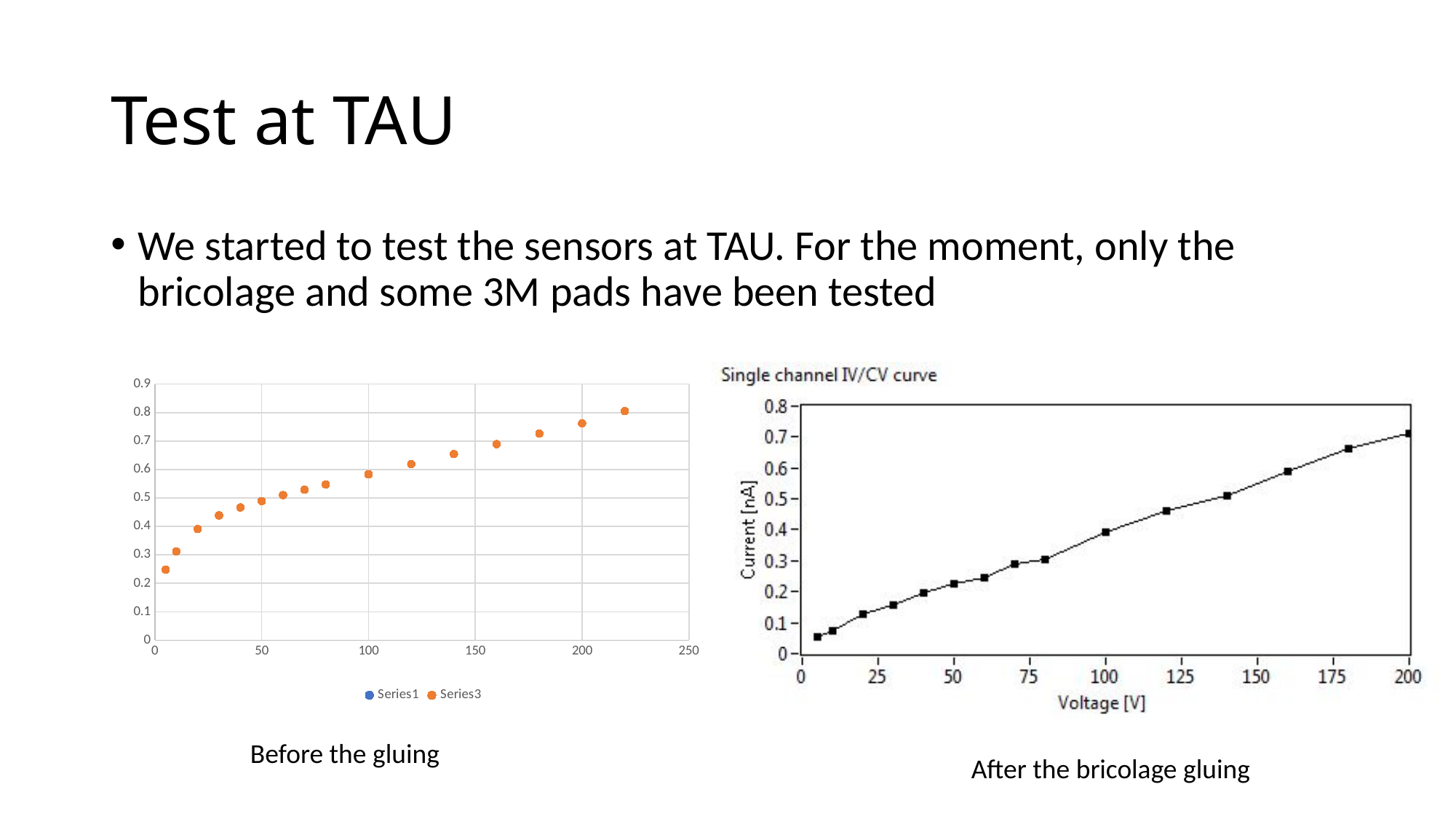
In the right chart ("Single channel IV/CV curve"), is the current at 50 V greater or less than 0.2 nA? greater In the right chart ("Single channel IV/CV curve"), at which voltage is the current lowest? 5 V In the left chart ("Before the gluing"), is the value at x = 100 greater or less than 0.5? greater In the left chart ("Before the gluing"), do the plotted values rise or fall as the x value increases? rise How many data points are plotted in the right chart ("Single channel IV/CV curve")? 15 What kind of chart is the right chart titled "Single channel IV/CV curve"? line chart In the right chart ("Single channel IV/CV curve"), does the current rise or fall as the voltage increases? rise How many series does the legend of the left chart ("Before the gluing") list? 2 What is the label of the x axis of the right chart ("Single channel IV/CV curve")? Voltage [V] How many data points are plotted in the left chart ("Before the gluing")? 16 In the right chart ("Single channel IV/CV curve"), at which voltage is the current highest? 200 V What kind of chart is the left chart labelled "Before the gluing"? scatter chart